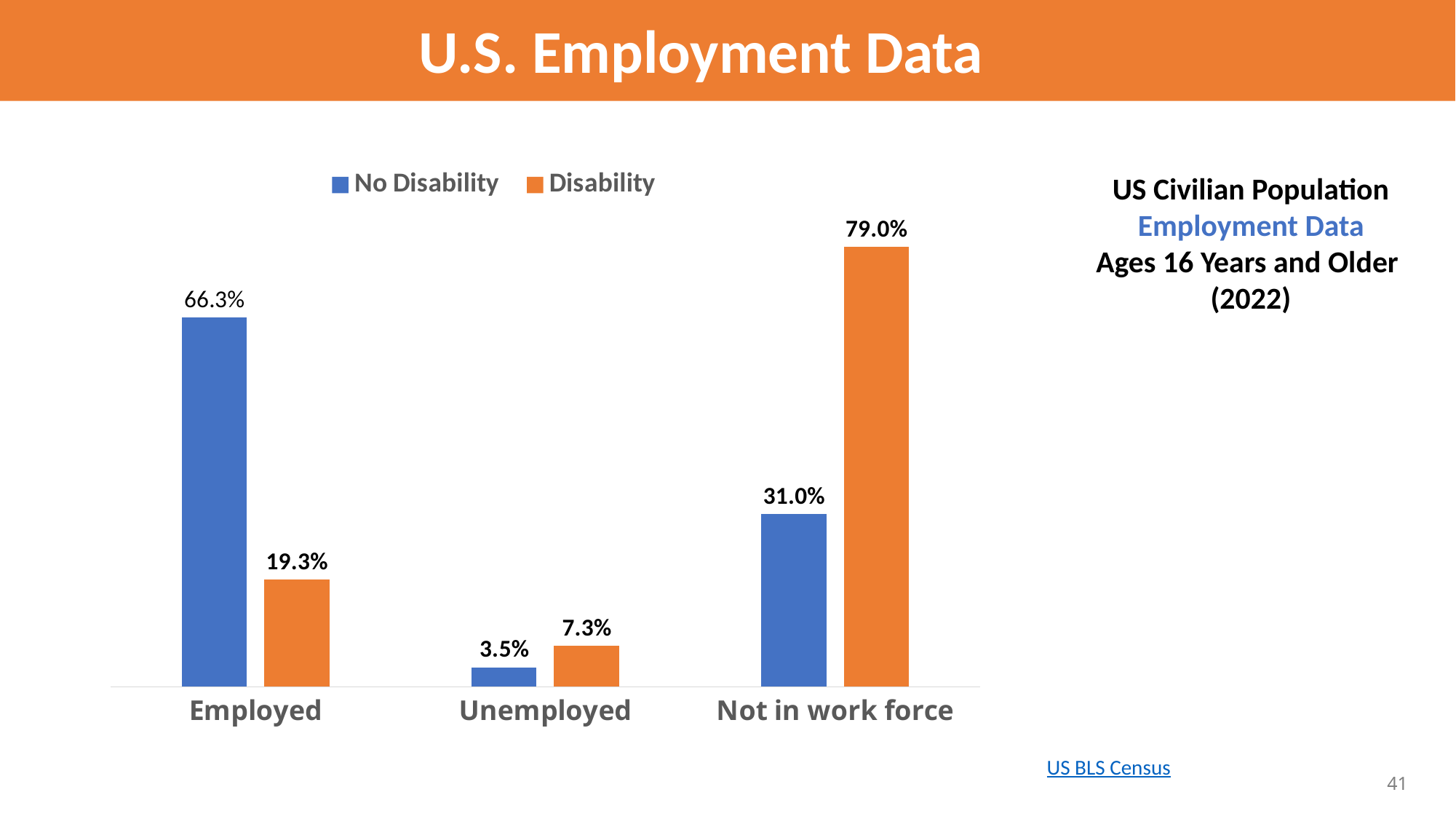
What is the difference between the Disability and No Disability values in the Employed category? 47.0% What is the difference between the Disability and No Disability values in the Not in work force category? 48.0% Which category has the highest value for the Disability series? Not in work force What is the value for No Disability in the Employed category? 66.3% What is the value for Disability in the Not in work force category? 79.0% What is the value for No Disability in the Not in work force category? 31.0% What kind of chart is shown on the slide? Bar chart What is the value for Disability in the Unemployed category? 7.3% In the Unemployed category, which series has the larger value, No Disability or Disability? Disability How many categories are shown on the x axis? 3 How many series does the legend list? 2 Which category has the lowest value for the No Disability series? Unemployed